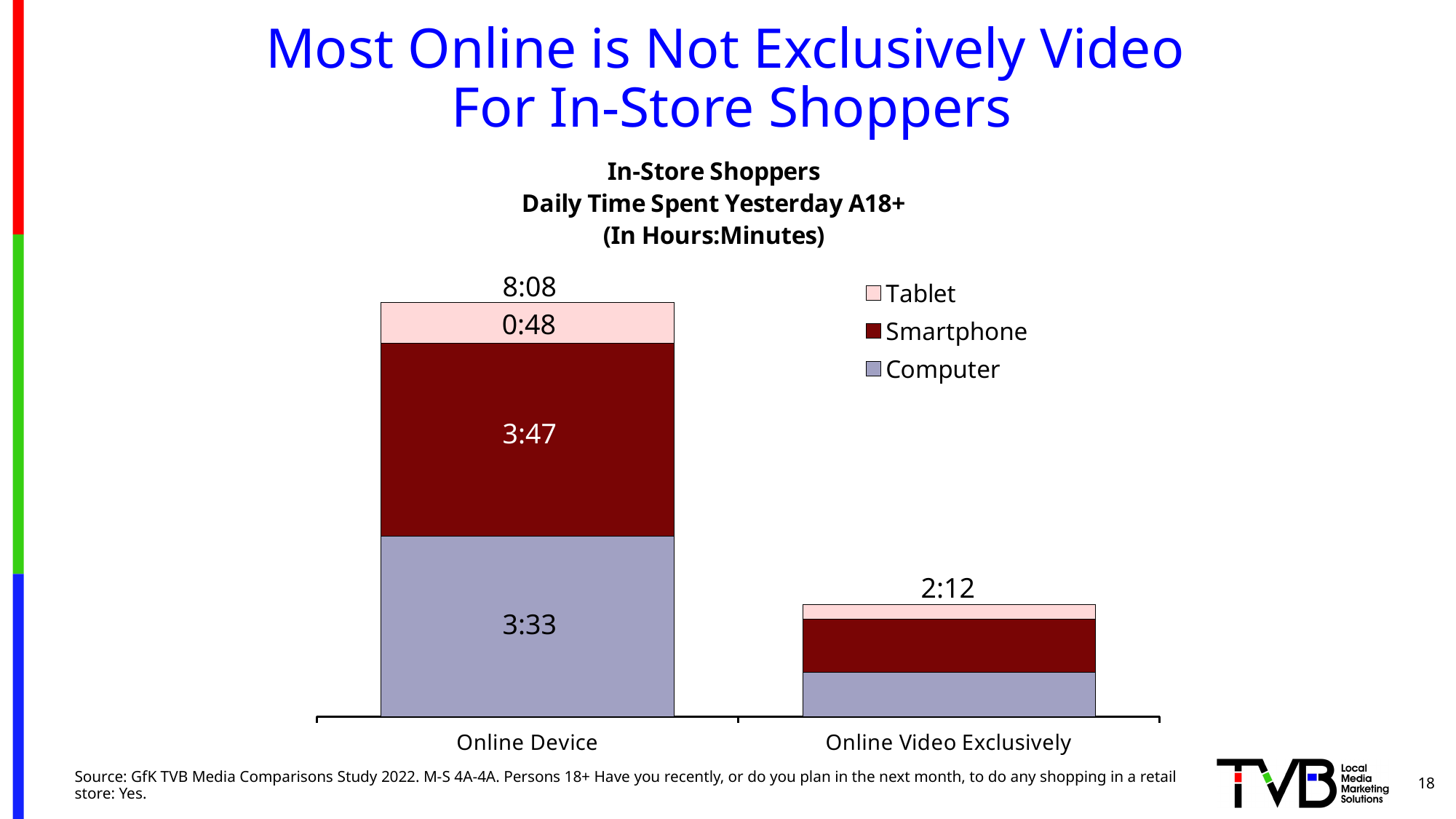
What is the Tablet value for Online Device? 0:48 What is the total daily time spent for Online Video Exclusively? 2:12 Which category has the higher total daily time spent? Online Device What is the difference between the Online Device total and the Online Video Exclusively total? 5:56 How many series does the legend list? 3 What is the Computer value for Online Device? 3:33 Which category has the lower total daily time spent? Online Video Exclusively What is the total daily time spent for Online Device? 8:08 Within the Online Device bar, which segment is larger: Smartphone or Computer? Smartphone What unit of measurement does the chart title say the values are in? Hours:Minutes What is the Smartphone value for Online Device? 3:47 What kind of chart is shown on the slide? Stacked bar chart